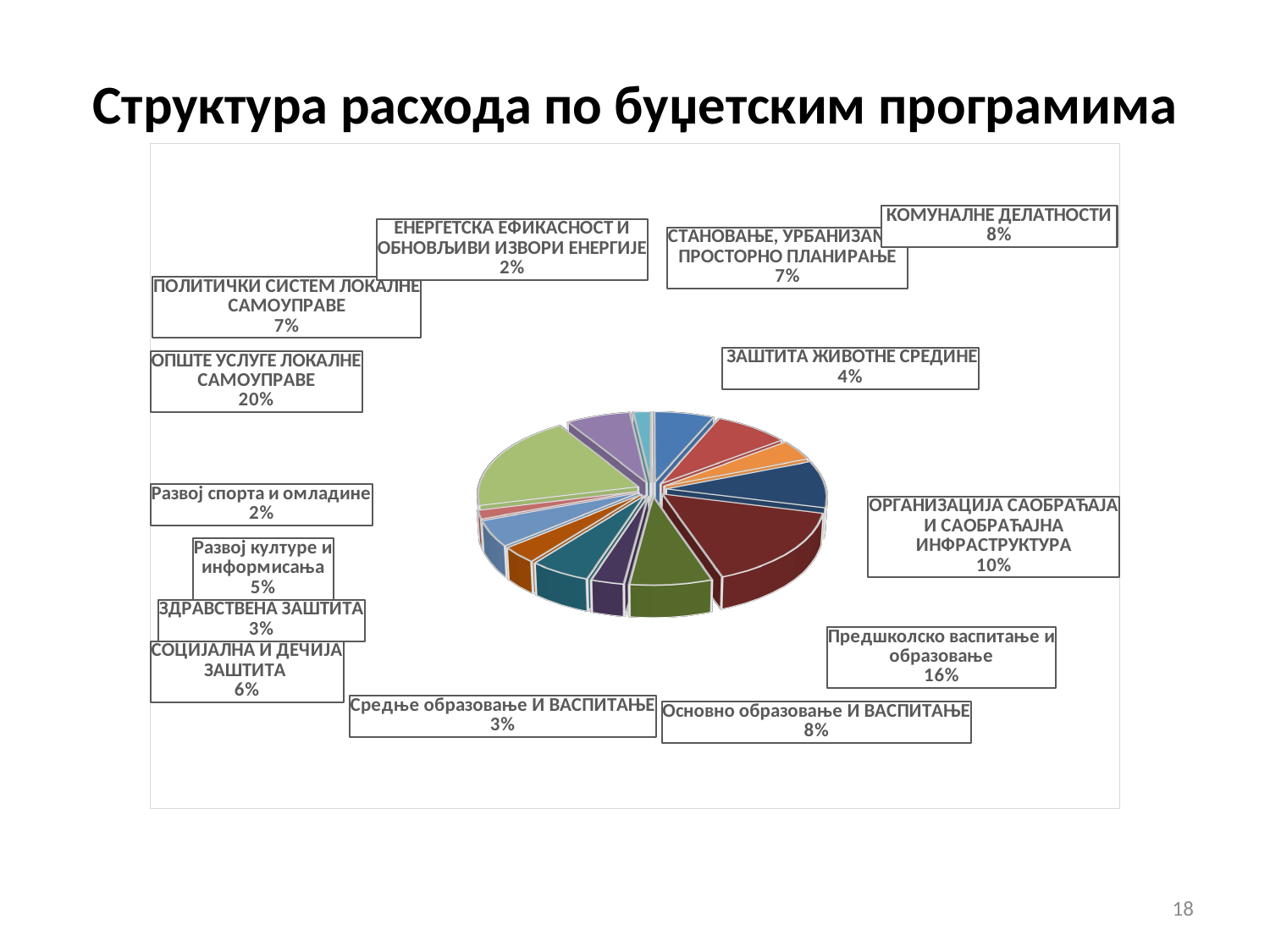
Which category has the largest share of the pie? ОПШТЕ УСЛУГЕ ЛОКАЛНЕ САМОУПРАВЕ What is the difference between the shares of ОПШТЕ УСЛУГЕ ЛОКАЛНЕ САМОУПРАВЕ and Предшколско васпитање и образовање? 4% What is the value for СОЦИЈАЛНА И ДЕЧИЈА ЗАШТИТА? 6% What share of the pie does Предшколско васпитање и образовање have? 16% What is the value for КОМУНАЛНЕ ДЕЛАТНОСТИ? 8% What is the difference between the shares of Развој културе и информисања and ЗДРАВСТВЕНА ЗАШТИТА? 2% What is the value for ЗАШТИТА ЖИВОТНЕ СРЕДИНЕ? 4% What kind of chart is shown on the slide? pie chart Which is larger, the share for Основно образовање И ВАСПИТАЊЕ or the share for Средње образовање И ВАСПИТАЊЕ? Основно образовање И ВАСПИТАЊЕ What is the value for ОРГАНИЗАЦИЈА САОБРАЋАЈА И САОБРАЋАЈНА ИНФРАСТРУКТУРА? 10% What is the title of the slide? Структура расхода по буџетским програмима What share of the pie does ОПШТЕ УСЛУГЕ ЛОКАЛНЕ САМОУПРАВЕ have? 20%